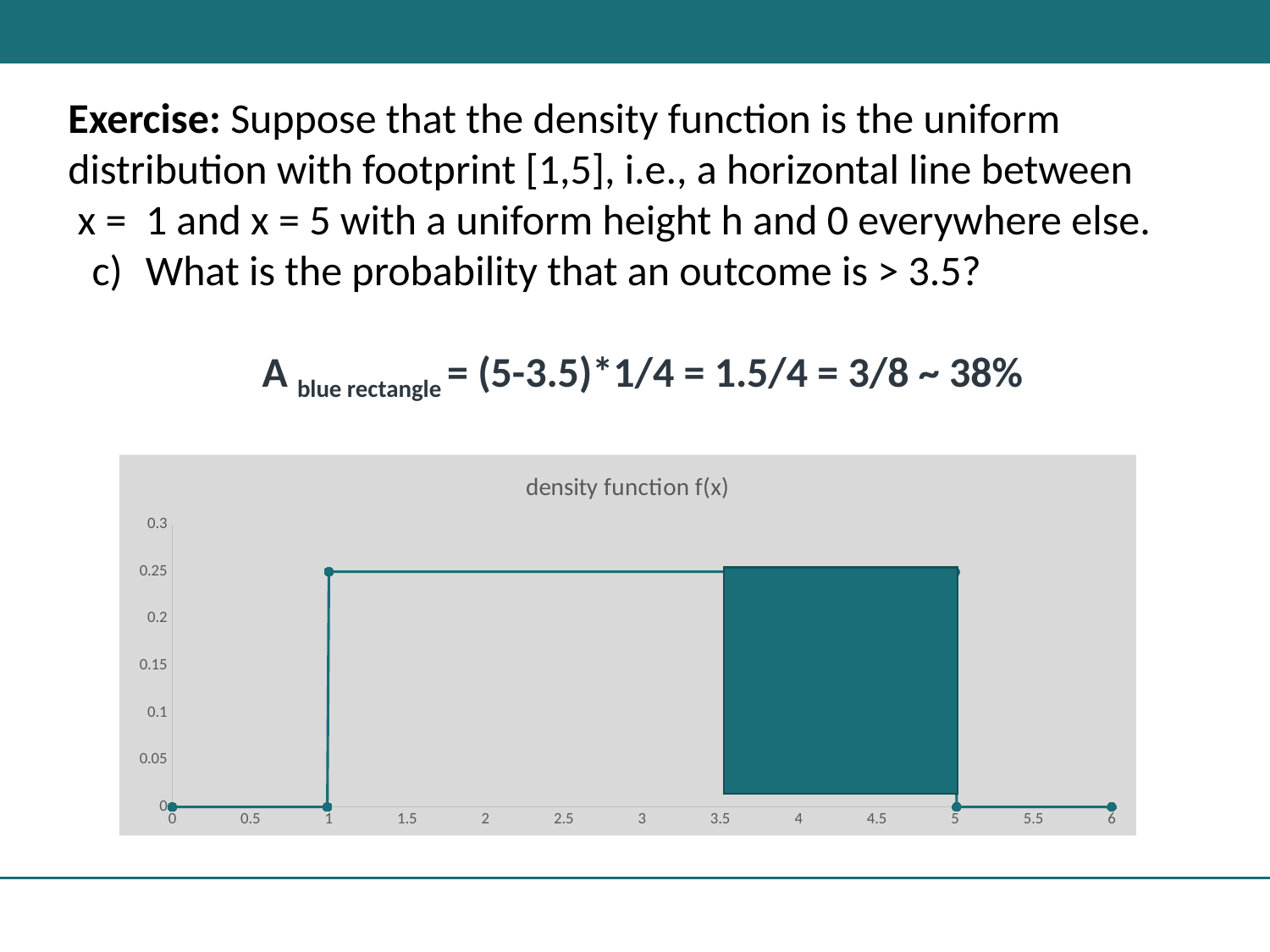
What kind of chart is shown on the slide? line chart Is the value of f(x) at x = 3 greater or less than 0.2? greater Does the value of f(x) rise, fall, or stay constant between x = 1.5 and x = 4.5? stay constant Which is larger, the value of f(x) at x = 2 or at x = 5.5? x = 2 Between which two x values does the shaded rectangle extend? 3.5 and 5 What is the title of the chart? density function f(x) What is the value of f(x) at x = 0? 0 What is the value of f(x) on the horizontal segment between x = 1 and x = 5? 0.25 What is the value of f(x) at x = 6? 0 Is the value of f(x) at x = 0.5 greater or less than 0.1? less How many tick labels are shown on the x axis? 13 What is the highest tick label shown on the y axis? 0.3